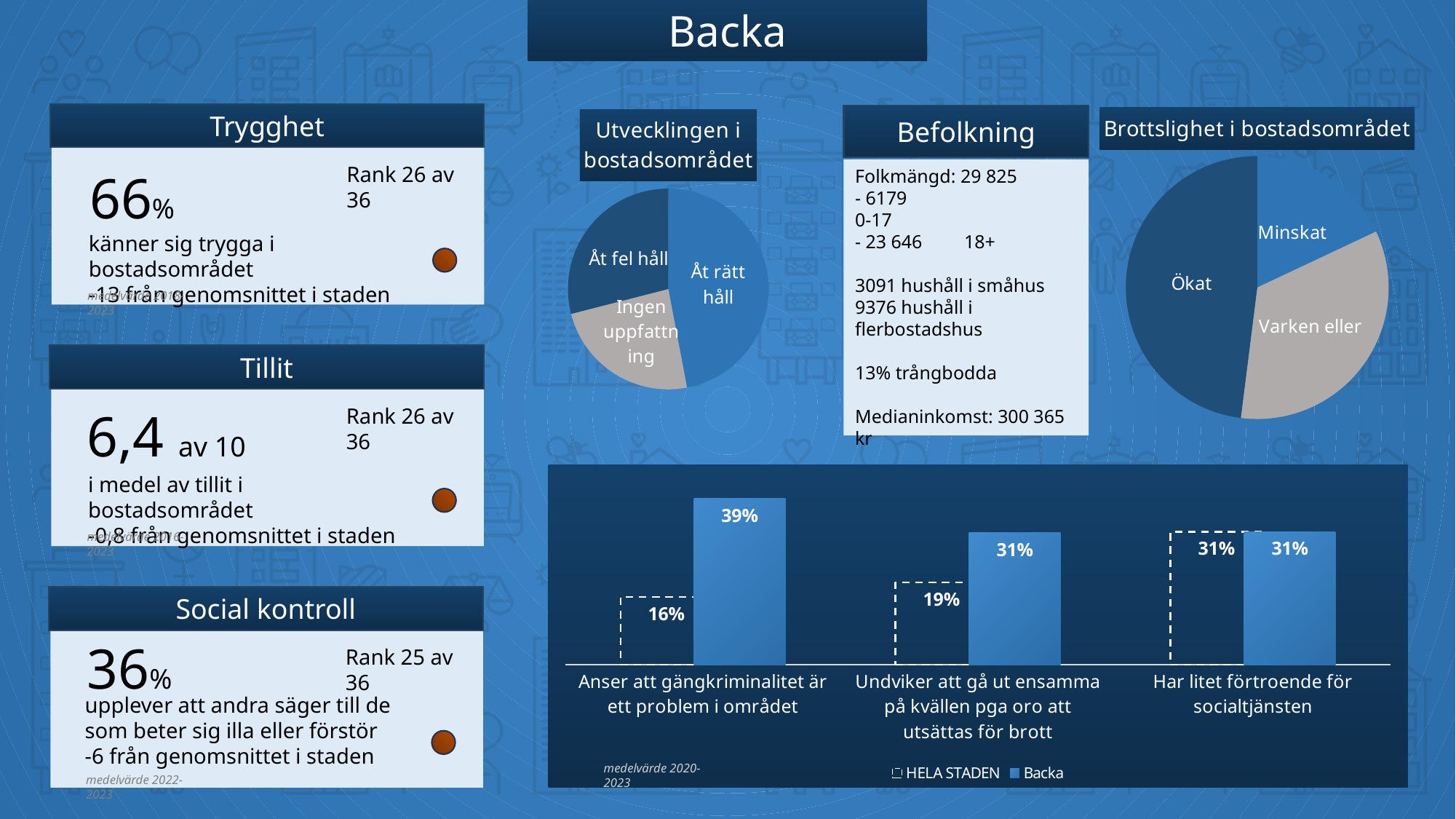
In the 'Brottslighet i bostadsområdet' pie chart, which slice is the smallest? Minskat In the bottom bar chart, what is the difference between the Backa and HELA STADEN values for 'Anser att gängkriminalitet är ett problem i området'? 23 percentage points In the bottom bar chart, which category has the lowest HELA STADEN value? Anser att gängkriminalitet är ett problem i området In the bottom bar chart, which category has the highest Backa value? Anser att gängkriminalitet är ett problem i området What kind of chart is 'Utvecklingen i bostadsområdet'? Pie chart In the bottom bar chart, what is the Backa value for 'Har litet förtroende för socialtjänsten'? 31% How many series does the legend of the bottom bar chart list? 2 In the bottom bar chart, what is the Backa value for 'Anser att gängkriminalitet är ett problem i området'? 39% In the bottom bar chart, which is larger for 'Undviker att gå ut ensamma på kvällen pga oro att utsättas för brott': Backa or HELA STADEN? Backa In the bottom bar chart, what is the HELA STADEN value for 'Undviker att gå ut ensamma på kvällen pga oro att utsättas för brott'? 19% How many categories are shown in the bottom bar chart? 3 In the 'Utvecklingen i bostadsområdet' pie chart, which slice is the largest? Åt rätt håll